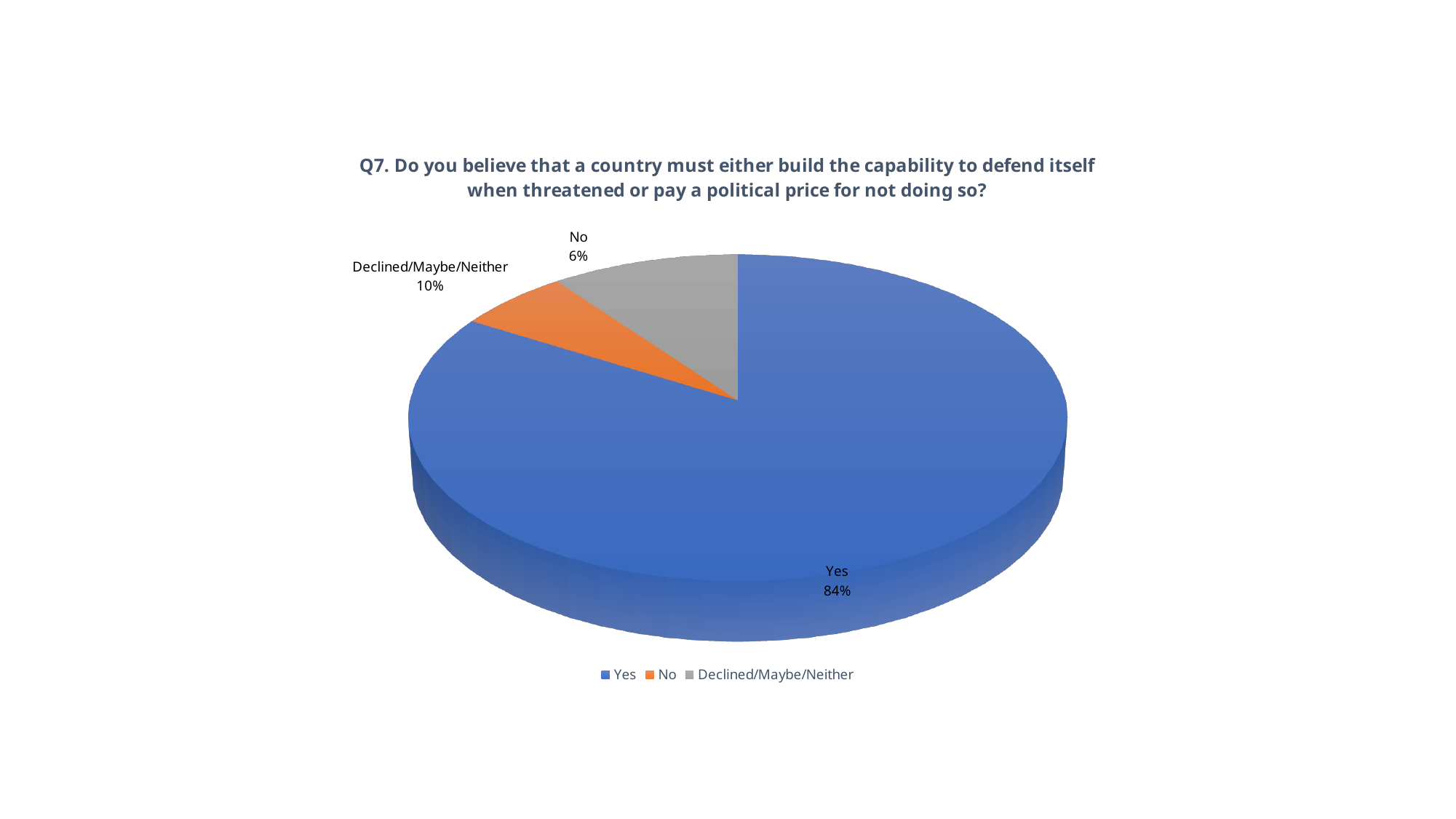
What is the difference in percentage points between Yes and No? 78 How many slices does the pie chart have? 3 Which response has the largest share of the pie? Yes What percentage of respondents answered Yes? 84% What percentage of respondents answered No? 6% What is the difference in percentage points between Declined/Maybe/Neither and No? 4 What percentage of respondents fall under Declined/Maybe/Neither? 10% What kind of chart is shown on the slide? Pie chart Which response has the smallest share of the pie? No What colour is the slice for No? Orange Which is larger, the share for No or the share for Declined/Maybe/Neither? Declined/Maybe/Neither What is the combined share of No and Declined/Maybe/Neither? 16%